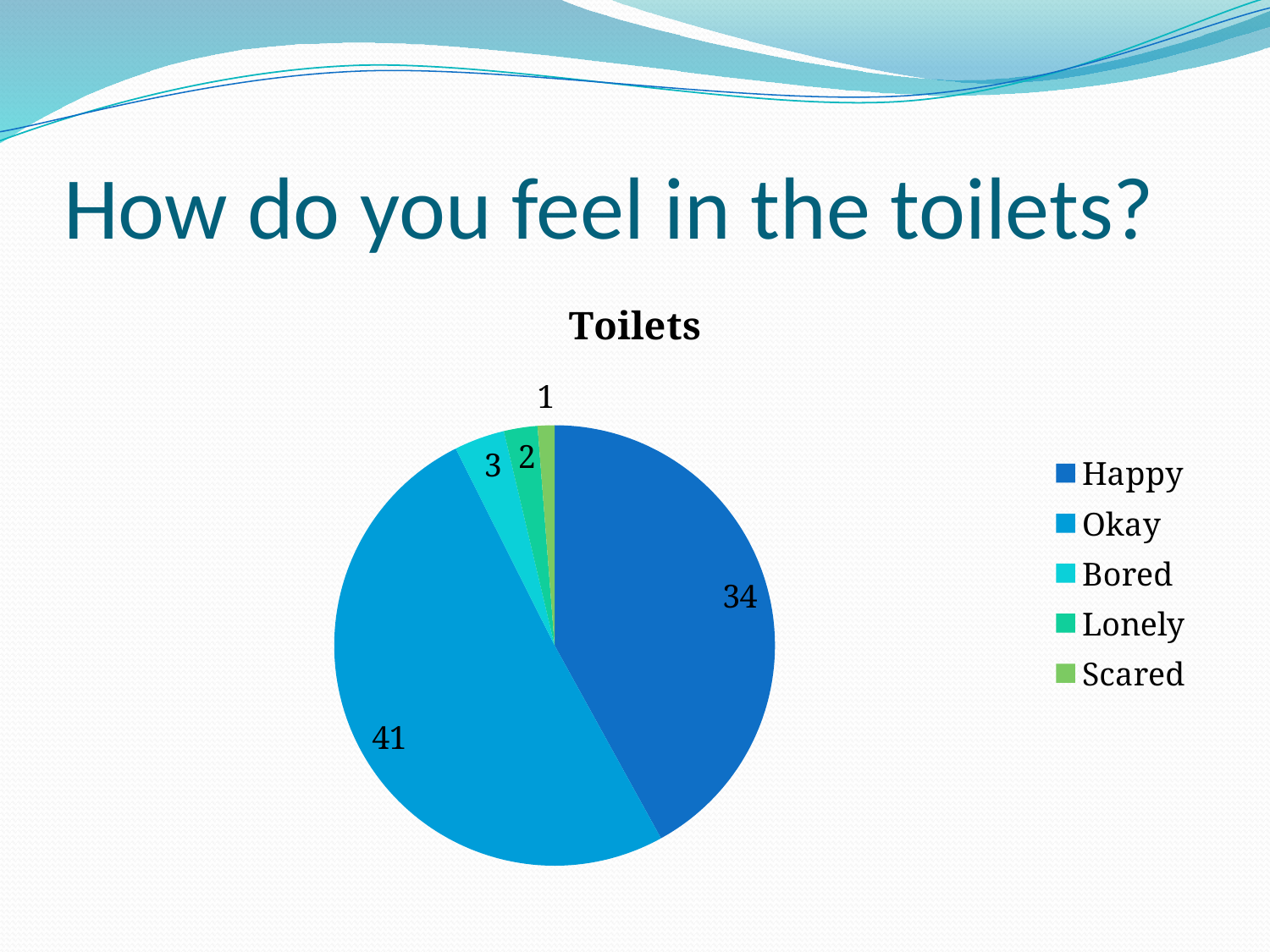
What kind of chart is shown on the slide? Pie chart What is the value for Scared in the Toilets pie chart? 1 What is the title of the chart on the slide? Toilets Which is larger in the Toilets pie chart, Bored or Lonely? Bored What is the value for Okay in the Toilets pie chart? 41 How many categories does the Toilets pie chart show? 5 Which category has the smallest slice in the Toilets pie chart? Scared Which category has the largest slice in the Toilets pie chart? Okay What is the difference between the Okay and Happy values in the Toilets pie chart? 7 What is the value for Bored in the Toilets pie chart? 3 What is the total of all slices in the Toilets pie chart? 81 What is the value for Happy in the Toilets pie chart? 34